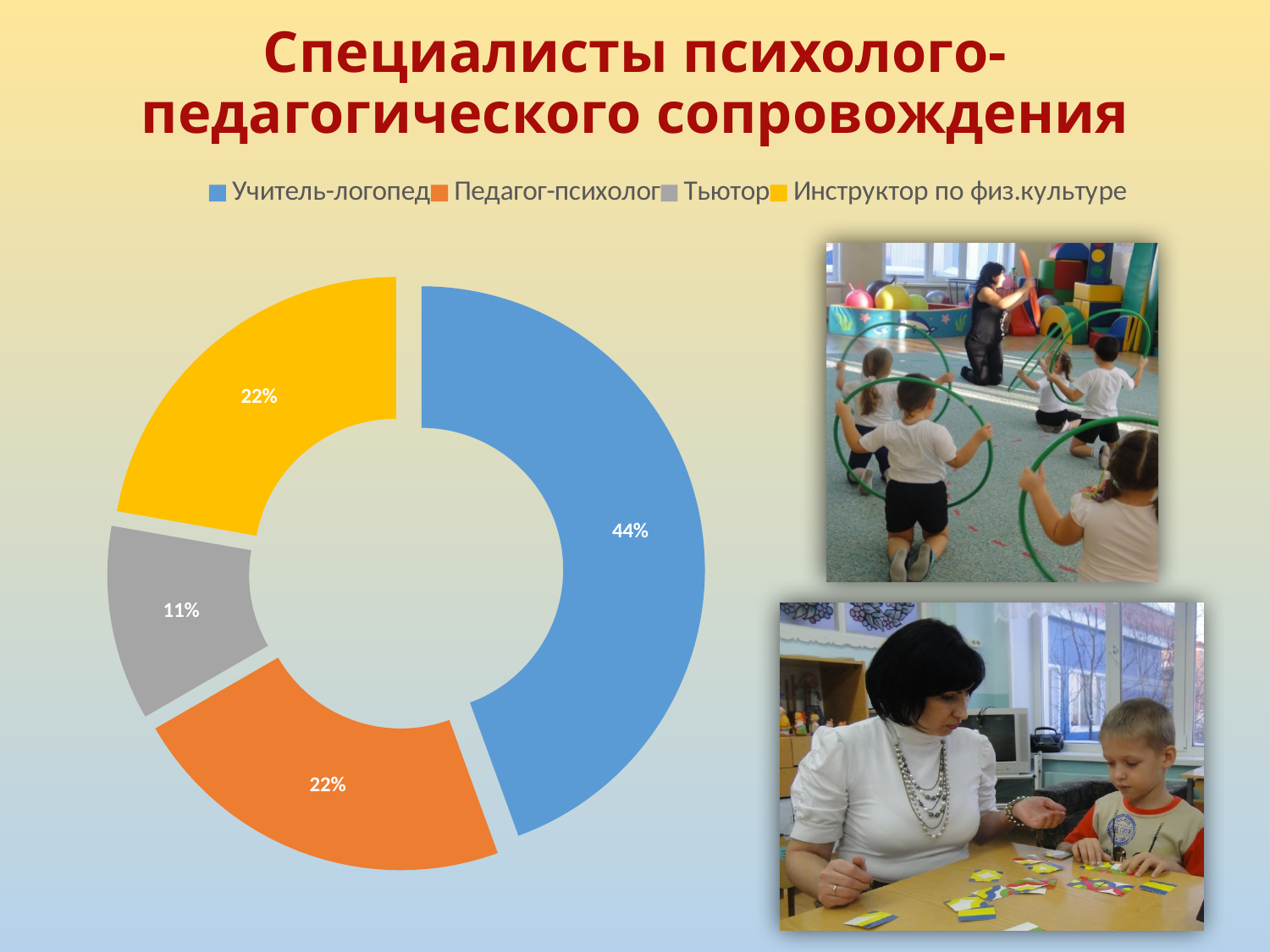
What is the title of the slide? Специалисты психолого-педагогического сопровождения Which is larger, the share for Учитель-логопед or the share for Педагог-психолог? Учитель-логопед What share of the chart does Тьютор have? 11% What share of the chart does Педагог-психолог have? 22% Which category has the largest share of the chart? Учитель-логопед How many categories does the chart show? 4 What is the difference in percentage points between Учитель-логопед and Тьютор? 33 What colour is the segment for Тьютор? Grey What kind of chart is shown on the slide? Doughnut chart What share of the chart does Учитель-логопед have? 44% Which category has the smallest share of the chart? Тьютор What share of the chart does Инструктор по физ.культуре have? 22%